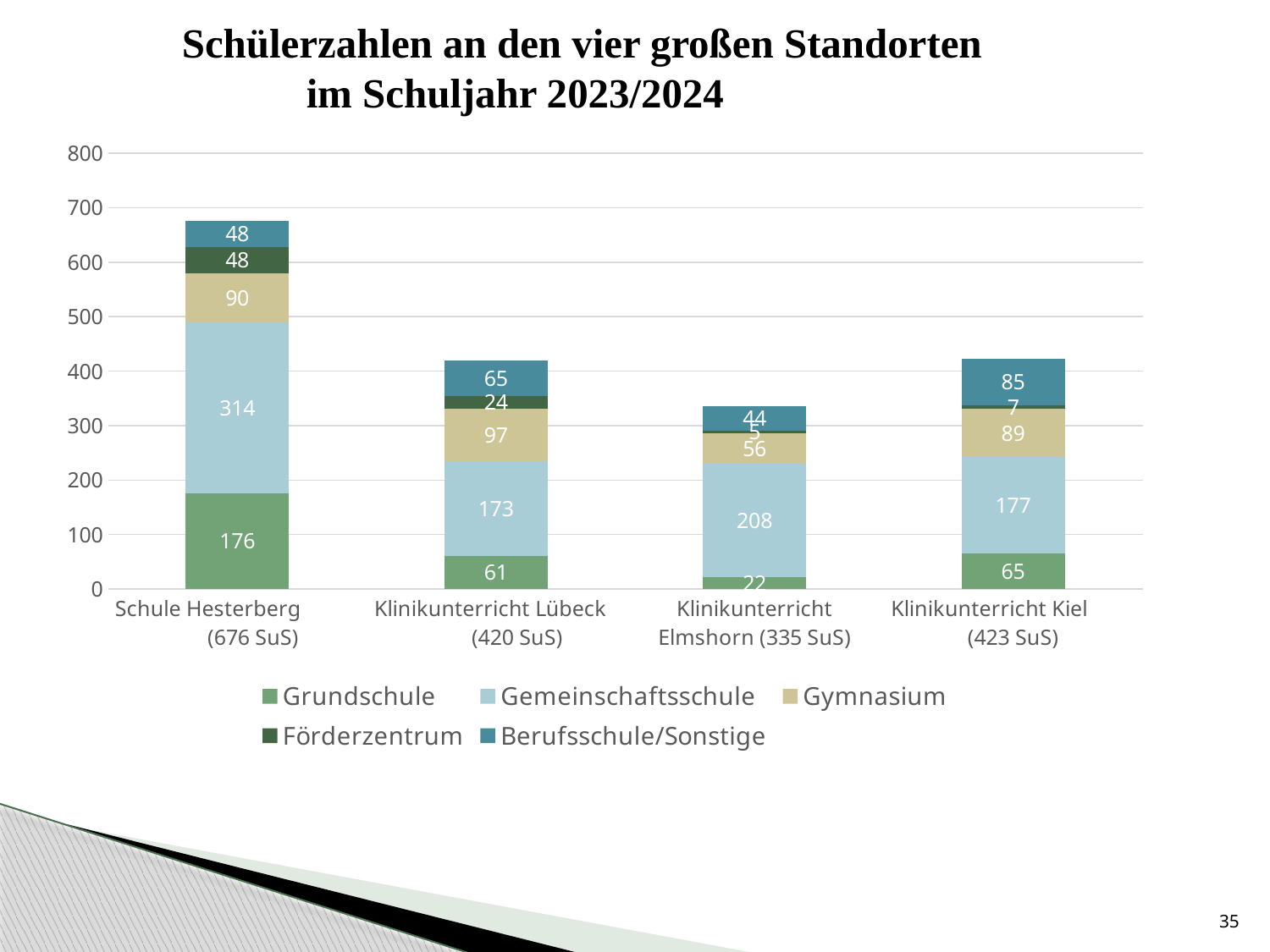
Which is larger, the Gemeinschaftsschule value for Klinikunterricht Elmshorn or for Klinikunterricht Kiel? Klinikunterricht Elmshorn What is the Berufsschule/Sonstige value for Klinikunterricht Kiel? 85 How many series does the legend list? 5 What is the difference between the Gymnasium values for Klinikunterricht Lübeck and Klinikunterricht Kiel? 8 What is the Gemeinschaftsschule value for Schule Hesterberg? 314 Which location has the highest total number of students? Schule Hesterberg Which location has the lowest total number of students? Klinikunterricht Elmshorn What is the Grundschule value for Klinikunterricht Elmshorn? 22 What is the total of the stacked bar for Klinikunterricht Lübeck? 420 What type of chart is shown on the slide? Stacked bar chart How many locations (categories) are shown on the x axis? 4 Is the total for Schule Hesterberg greater or less than 600? greater